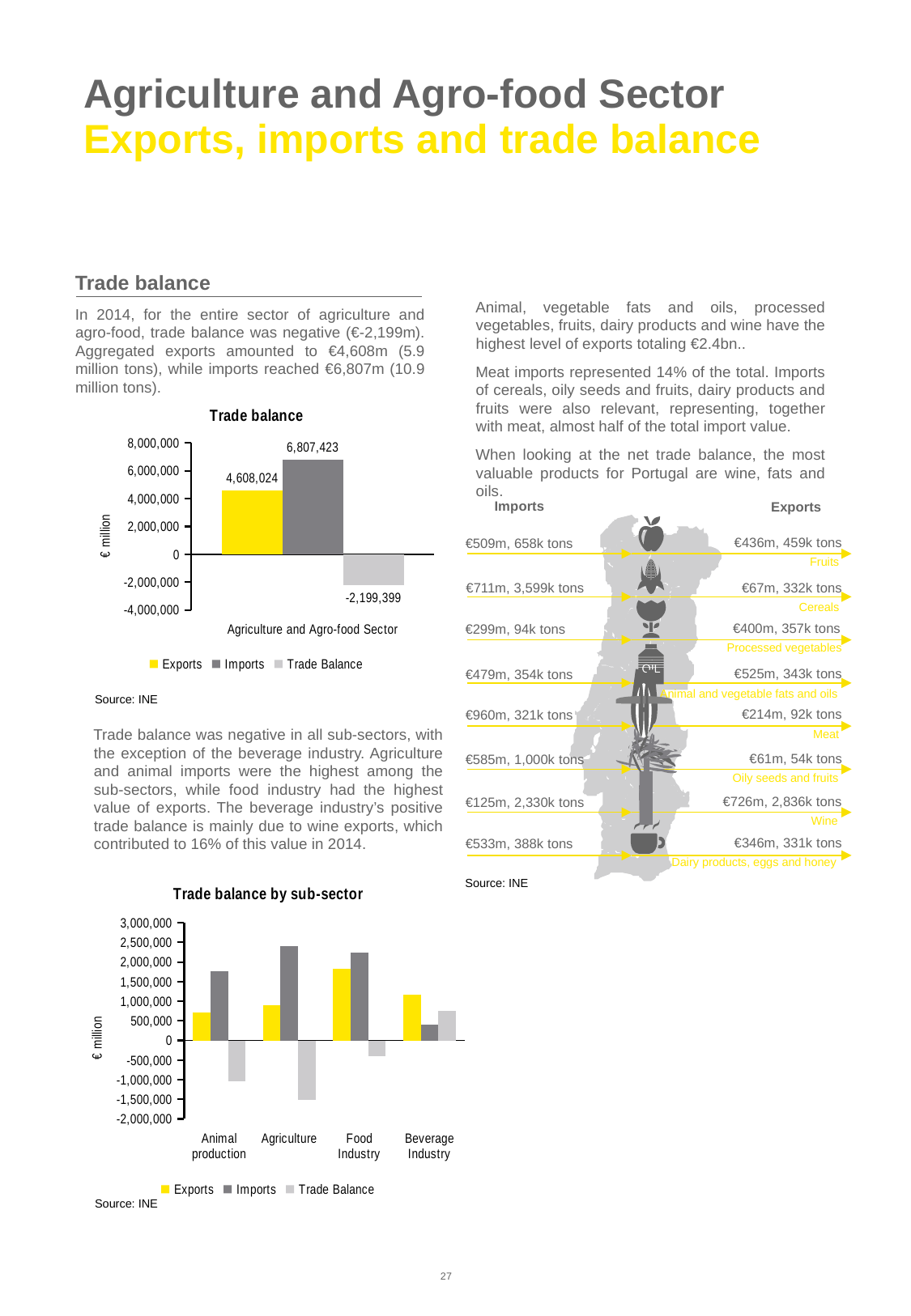
What kind of chart is the 'Trade balance by sub-sector' chart? Bar chart How many sub-sectors are shown on the x axis of the 'Trade balance by sub-sector' chart? 4 In the 'Trade balance' chart, what is the value for Exports? 4,608,024 In the 'Trade balance' chart, what is the difference between Imports and Exports? 2,199,399 How many series does the legend of the 'Trade balance' chart list? 3 In the 'Trade balance by sub-sector' chart, which sub-sector has the lowest Imports? Beverage Industry In the 'Trade balance by sub-sector' chart, which sub-sector has the highest Exports? Food Industry In the 'Trade balance by sub-sector' chart, is the Exports value for Animal production greater or less than 1,000,000? less In the 'Trade balance' chart, which is larger, Exports or Imports? Imports In the 'Trade balance by sub-sector' chart, is the Imports value for Agriculture greater or less than 2,000,000? greater In the 'Trade balance' chart, what is the value for Trade Balance? -2,199,399 In the 'Trade balance' chart, what is the value for Imports? 6,807,423